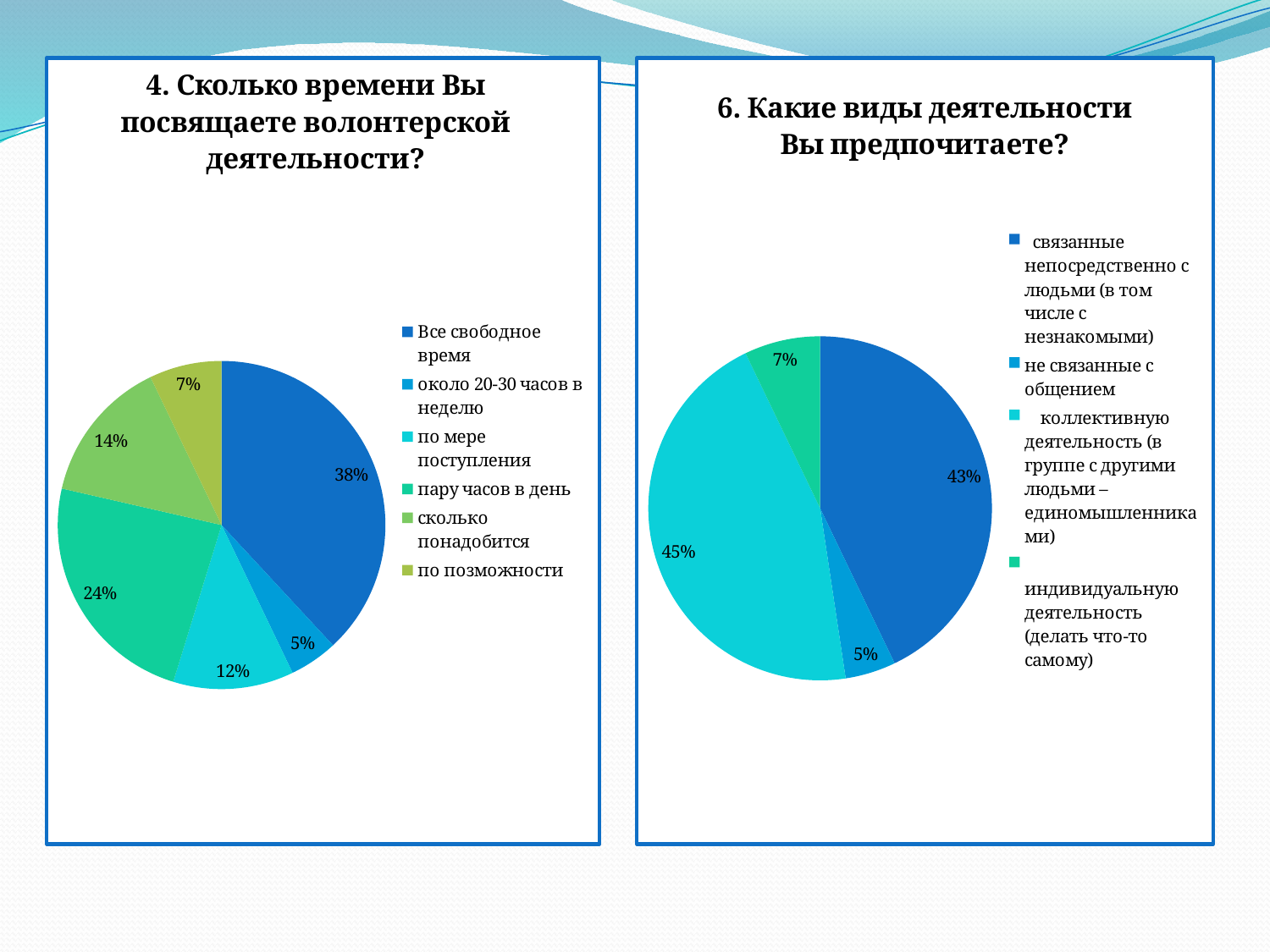
On the left chart (question 4), which is larger: "сколько понадобится" or "по мере поступления"? сколько понадобится On the left chart (question 4), what is the difference between the shares for "Все свободное время" and "пару часов в день"? 14% On the left chart (question 4), which category has the largest share? Все свободное время On the left chart (question 4), what share of respondents chose "Все свободное время"? 38% On the right chart (question 6), which category has the largest share? коллективную деятельность On the right chart (question 6), how many categories does the legend list? 4 On the left chart (question 4), how many categories does the legend list? 6 On the left chart (question 4), what share of respondents chose "пару часов в день"? 24% On the right chart (question 6), what share of respondents chose "не связанные с общением"? 5% On the left chart (question 4), which category has the smallest share? около 20-30 часов в неделю On the right chart (question 6), what share of respondents chose "коллективную деятельность"? 45% What type of chart is used on the right side of the slide (question 6)? Pie chart